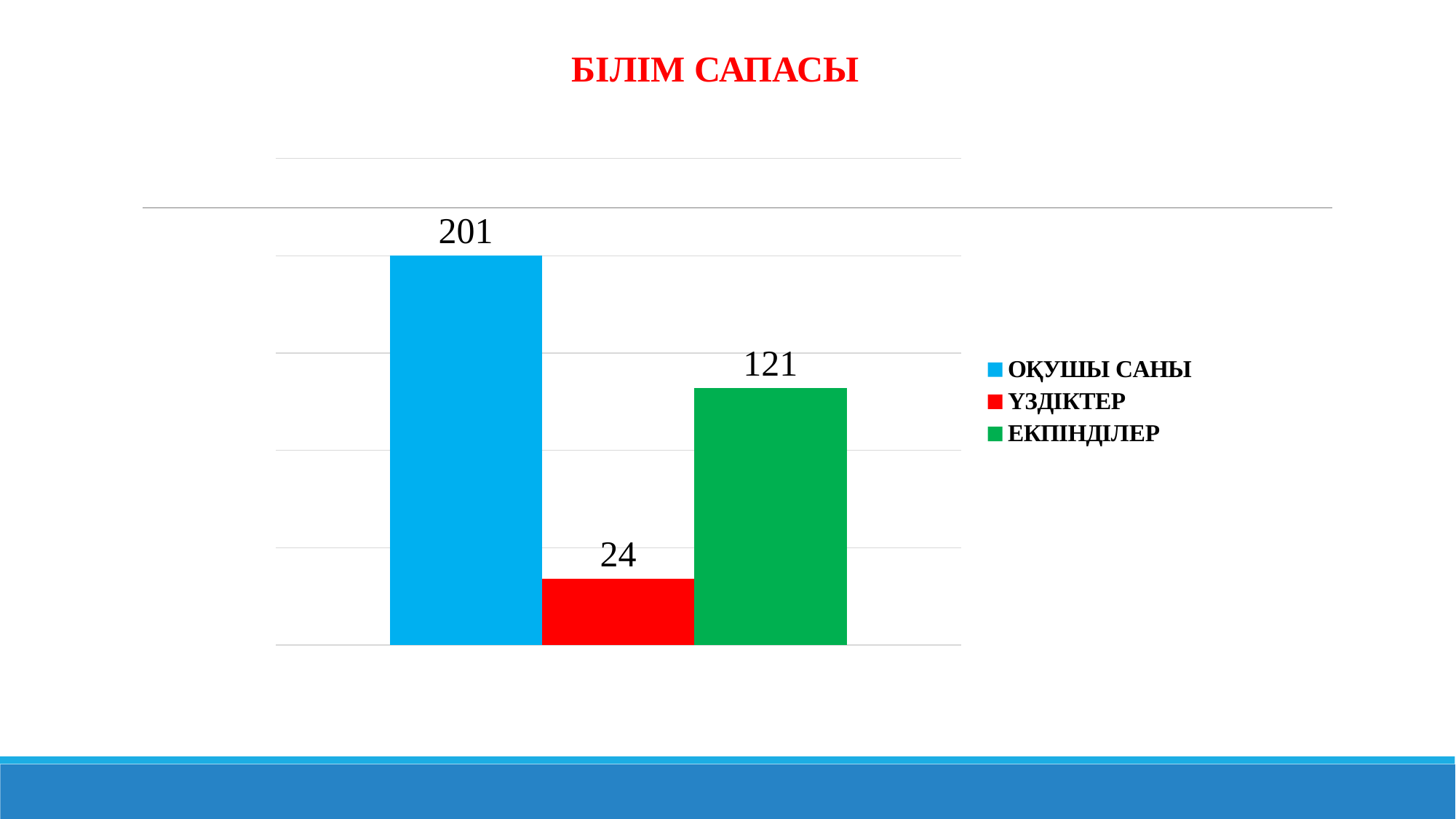
How many series does the legend list? 3 What is the value for ОҚУШЫ САНЫ? 201 What is the title of the slide? БІЛІМ САПАСЫ What is the value for ҮЗДІКТЕР? 24 What is the difference between the values for ОҚУШЫ САНЫ and ЕКПІНДІЛЕР? 80 What kind of chart is shown on the slide? bar chart What is the difference between the values for ЕКПІНДІЛЕР and ҮЗДІКТЕР? 97 How many bars are plotted on the chart? 3 What is the value for ЕКПІНДІЛЕР? 121 Which series has the lowest value? ҮЗДІКТЕР Which is larger, the value for ҮЗДІКТЕР or the value for ЕКПІНДІЛЕР? ЕКПІНДІЛЕР Which series has the highest value? ОҚУШЫ САНЫ